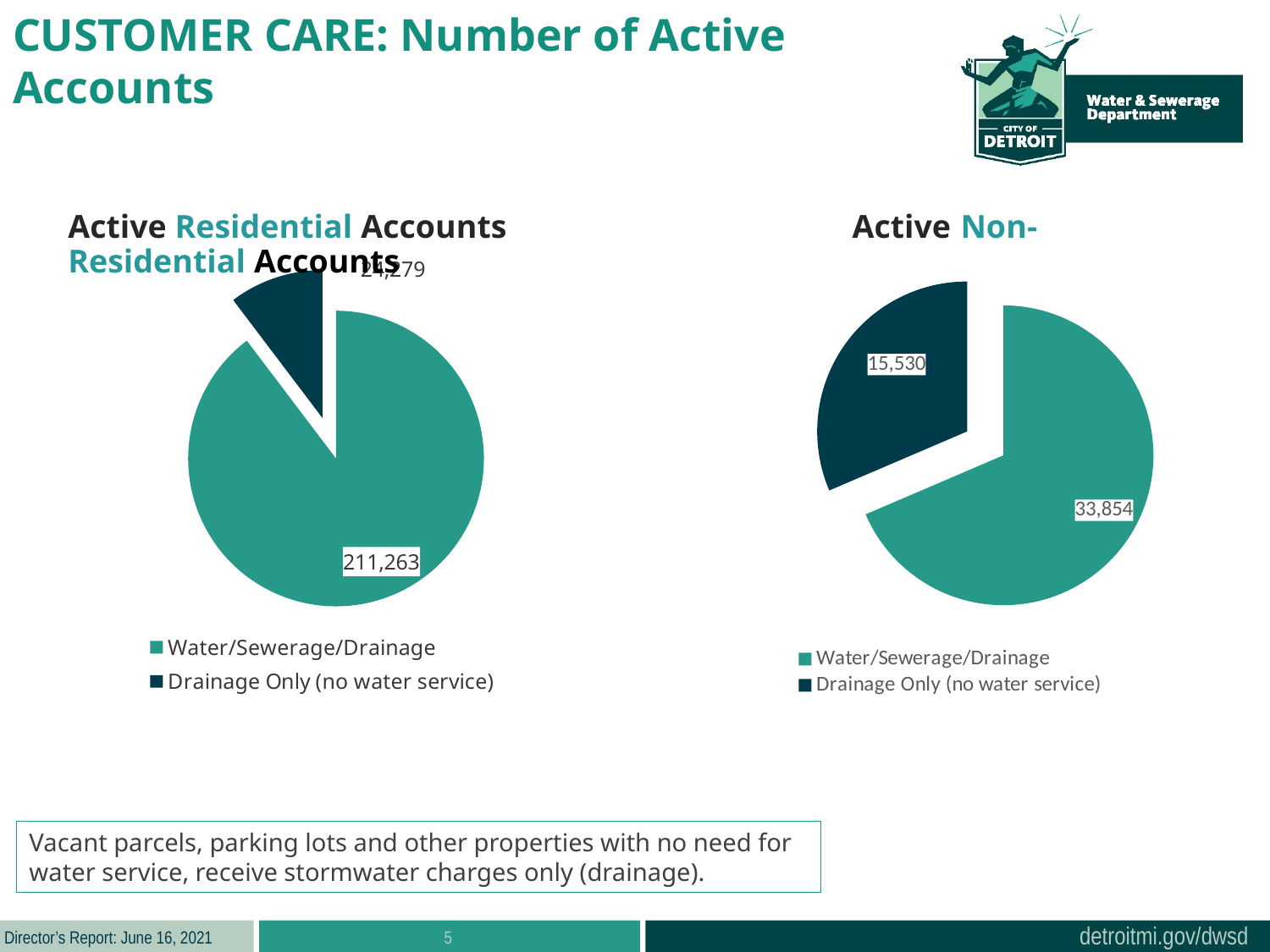
In the Active Residential Accounts pie chart, how many accounts are Water/Sewerage/Drainage? 211,263 Which is larger: the Water/Sewerage/Drainage value in the Active Residential Accounts chart or the Water/Sewerage/Drainage value in the Active Non-Residential Accounts chart? Active Residential Accounts What kind of chart is used for Active Residential Accounts? Pie chart In the Active Non-Residential Accounts pie chart, which category has the smallest slice? Drainage Only (no water service) In the Active Non-Residential Accounts pie chart, how many accounts are Drainage Only (no water service)? 15,530 In the Active Non-Residential Accounts pie chart, which legend entry is shown in the darker colour? Drainage Only (no water service) In the Active Residential Accounts pie chart, which category has the largest slice? Water/Sewerage/Drainage How many slices does the Active Non-Residential Accounts pie chart have? 2 In the Active Non-Residential Accounts pie chart, what is the difference between the Water/Sewerage/Drainage and Drainage Only (no water service) values? 18,324 In the Active Non-Residential Accounts pie chart, how many accounts are Water/Sewerage/Drainage? 33,854 How many entries does the legend of the Active Residential Accounts pie chart list? 2 In the Active Non-Residential Accounts pie chart, what is the total of the two slices? 49,384